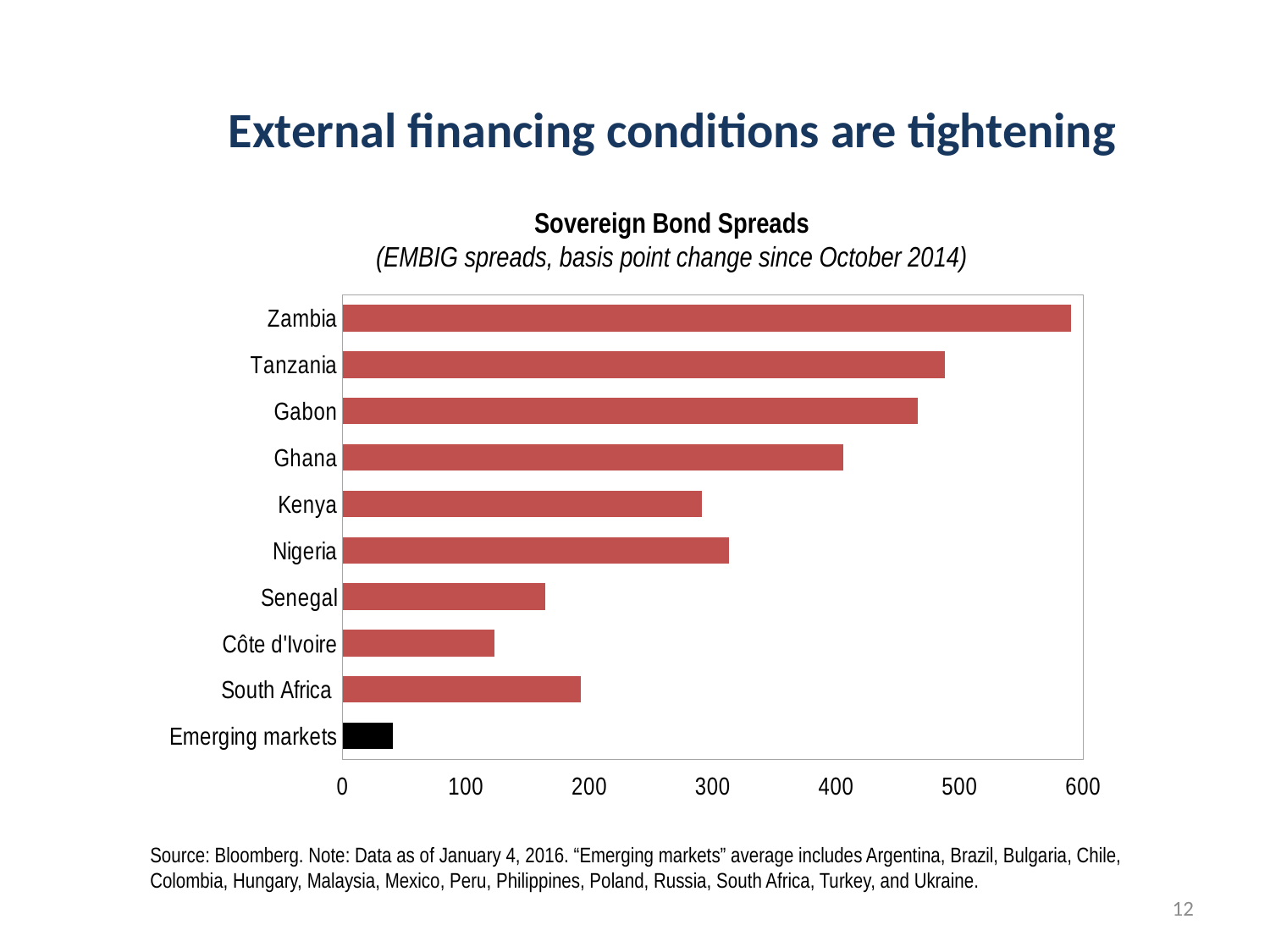
Which has the larger value, Nigeria or Kenya? Nigeria Is the value for Côte d'Ivoire greater or less than 100? greater Is the value for Zambia greater or less than 500? greater Is the value for Kenya greater or less than 300? less Which category has the lowest sovereign bond spread change? Emerging markets Which has the larger value, South Africa or Senegal? South Africa What is the title of the chart? Sovereign Bond Spreads What kind of chart is shown on the slide? bar chart How many categories are plotted in the chart? 10 Which category has the highest sovereign bond spread change? Zambia